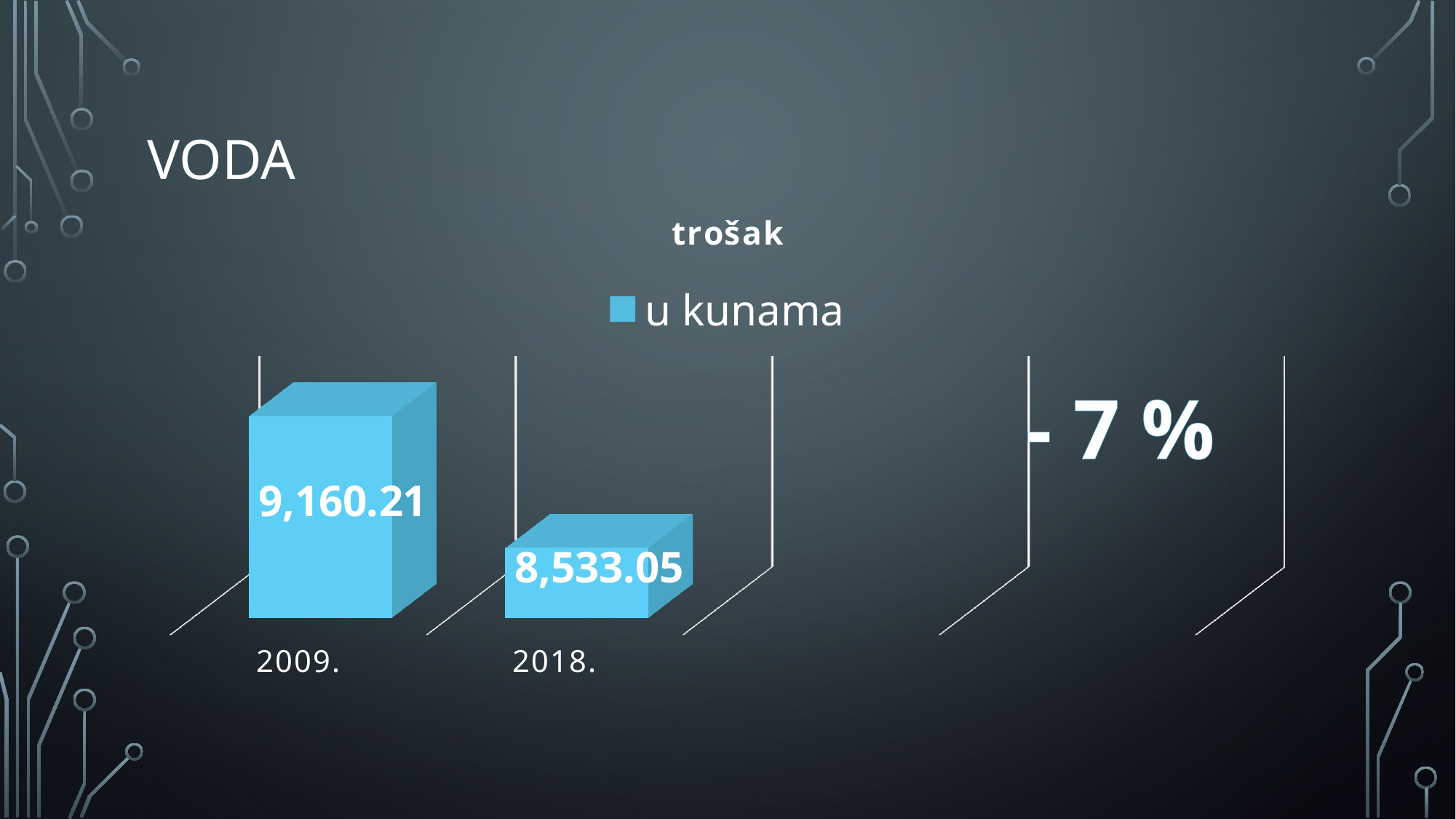
What is the value for 2018. in the chart? 8,533.05 Which year has the higher value in the chart? 2009. Is the value for 2018. larger or smaller than the value for 2009.? smaller How many categories are shown in the chart? 2 How many series does the legend list? 1 What is the difference between the values for 2009. and 2018.? 627.16 What is the legend entry of the chart? u kunama Which year has the lower value in the chart? 2018. What kind of chart is shown on the slide? bar chart What is the title of the chart? trošak What is the value for 2009. in the chart? 9,160.21 Do the values rise or fall from 2009. to 2018.? fall